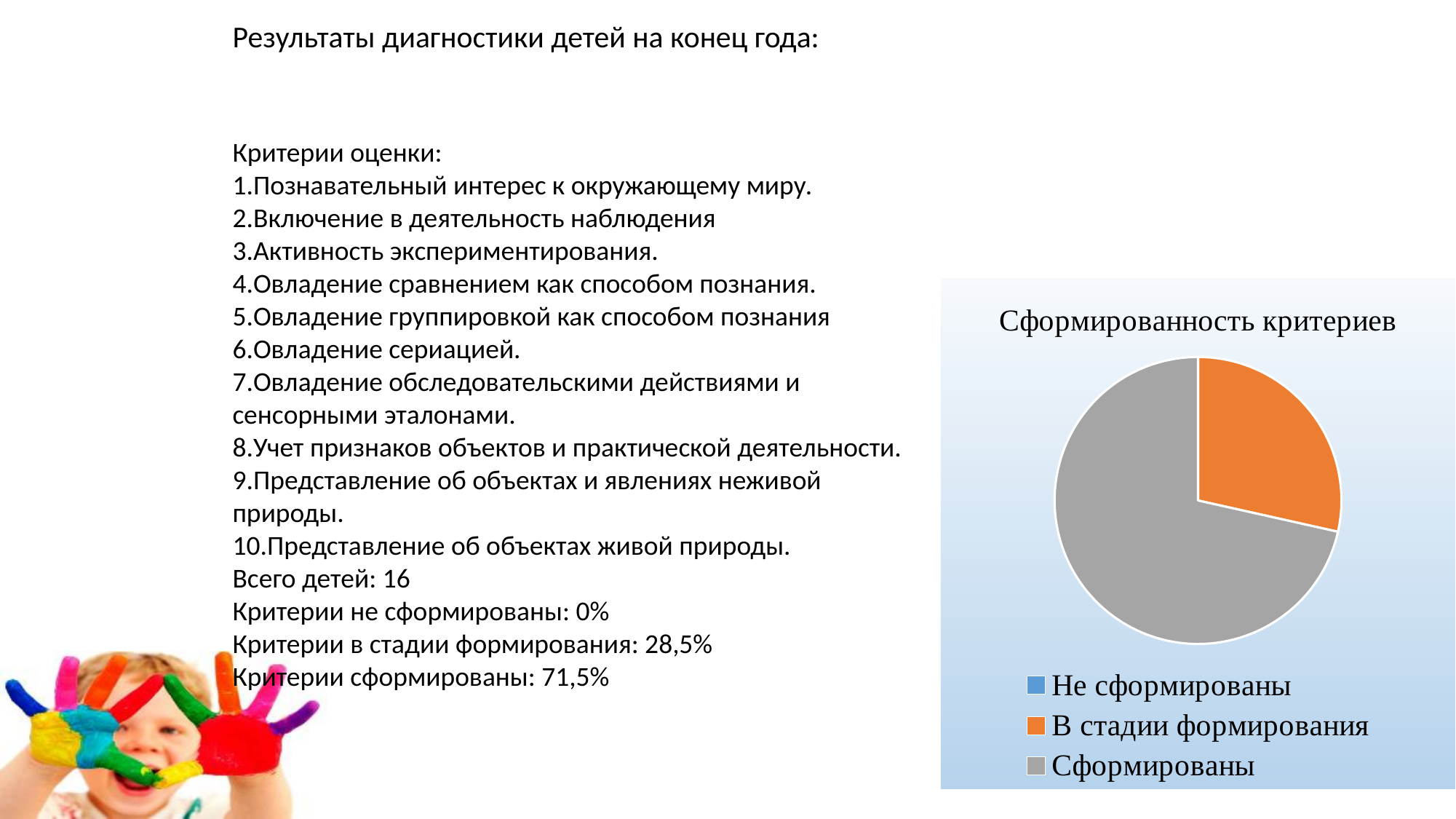
How many entries does the legend of the pie chart list? 3 Which category has the largest slice in the pie chart? Сформированы Which is larger in the pie chart: Сформированы or В стадии формирования? Сформированы What kind of chart is shown on the slide? pie chart According to the slide, what share corresponds to Не сформированы? 0% Is the share for Сформированы greater or less than 50%? greater According to the slide, what share of the pie corresponds to В стадии формирования? 28,5% What colour is the Сформированы slice in the pie chart? gray What is the title of the pie chart? Сформированность критериев According to the slide, what share of the pie corresponds to Сформированы? 71,5% Is the share for В стадии формирования greater or less than 50%? less What is the difference between the shares for Сформированы and В стадии формирования? 43%